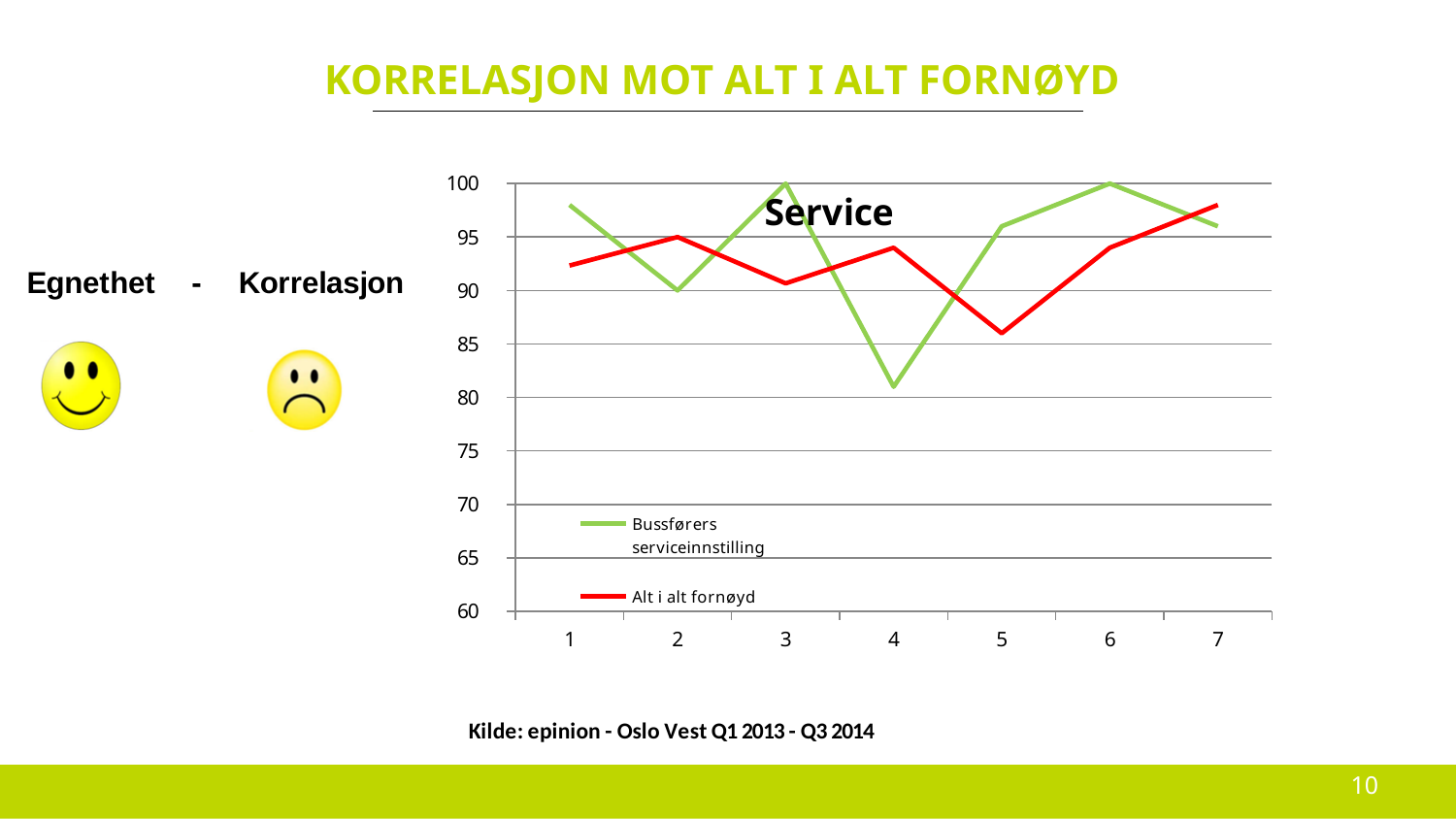
At point 4, which series has the higher value, Bussførers serviceinnstilling or Alt i alt fornøyd? Alt i alt fornøyd What is the title of the chart? Service Does the value for Bussførers serviceinnstilling rise or fall from point 3 to point 4? fall Is the value for Alt i alt fornøyd at point 5 greater or less than 90? less Is the value for Bussførers serviceinnstilling at point 4 greater or less than 85? less How many series does the legend of the chart list? 2 At which x-axis point is the value for Bussførers serviceinnstilling lowest? 4 What kind of chart is shown on the slide? Line chart Which series is drawn in red according to the legend? Alt i alt fornøyd At which x-axis point is the value for Alt i alt fornøyd lowest? 5 At point 1, which series has the higher value, Bussførers serviceinnstilling or Alt i alt fornøyd? Bussførers serviceinnstilling How many points are plotted along the x axis for each series? 7